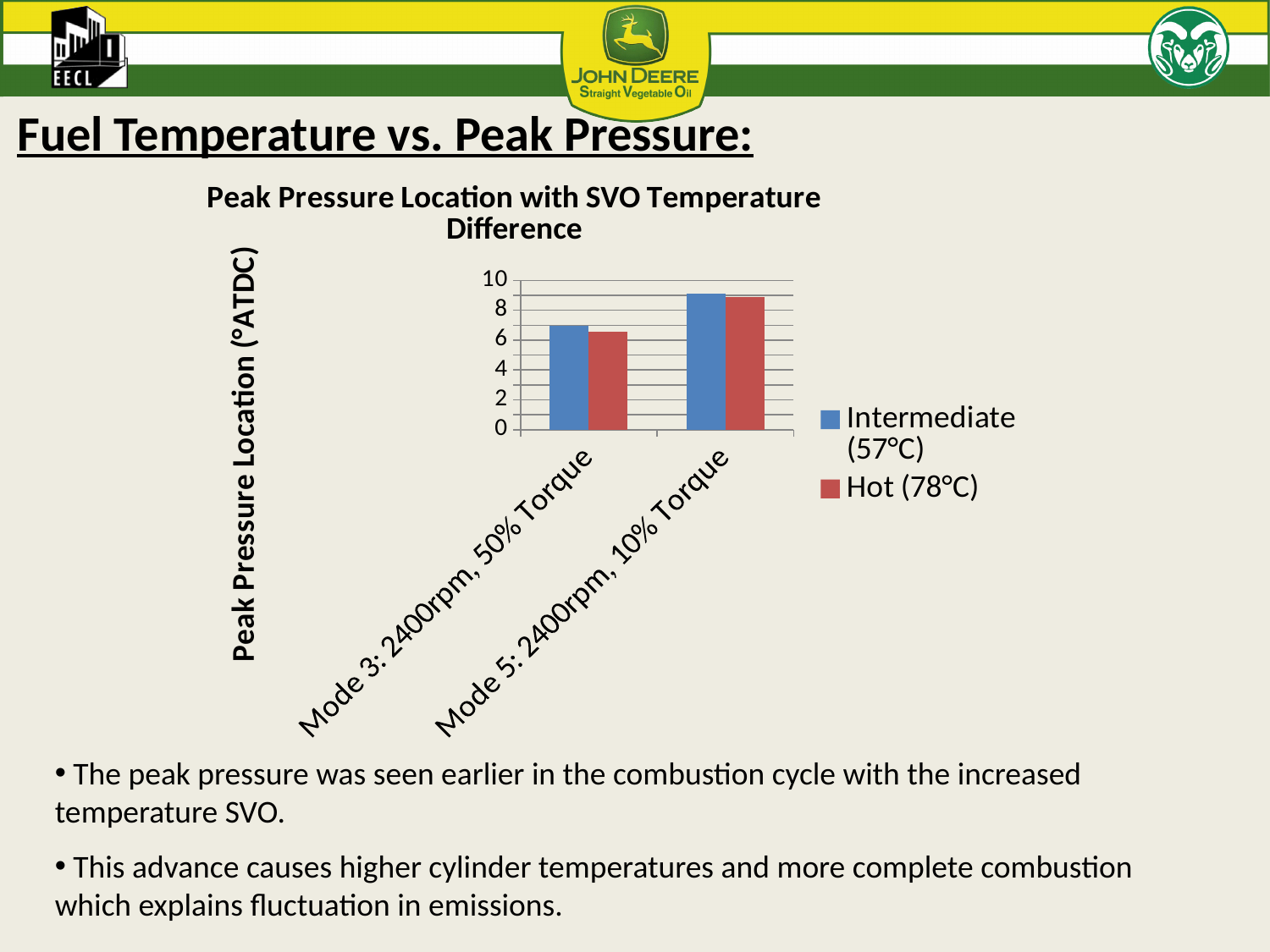
Is the Intermediate (57°C) value for Mode 5: 2400rpm, 10% Torque greater or less than 8? greater What kind of chart is shown on the slide? Bar chart What is the title of the chart? Peak Pressure Location with SVO Temperature Difference How many categories are shown on the x axis of the chart? 2 Is the Intermediate (57°C) value for Mode 3: 2400rpm, 50% Torque greater or less than 8? less Is the Intermediate (57°C) value for Mode 3: 2400rpm, 50% Torque greater or less than 6? greater How many series does the chart legend list? 2 What is the label of the y axis of the chart? Peak Pressure Location (°ATDC) For the Intermediate (57°C) series, which category has the larger value: Mode 3: 2400rpm, 50% Torque or Mode 5: 2400rpm, 10% Torque? Mode 5: 2400rpm, 10% Torque Do the Hot (78°C) values rise or fall from Mode 3: 2400rpm, 50% Torque to Mode 5: 2400rpm, 10% Torque? rise